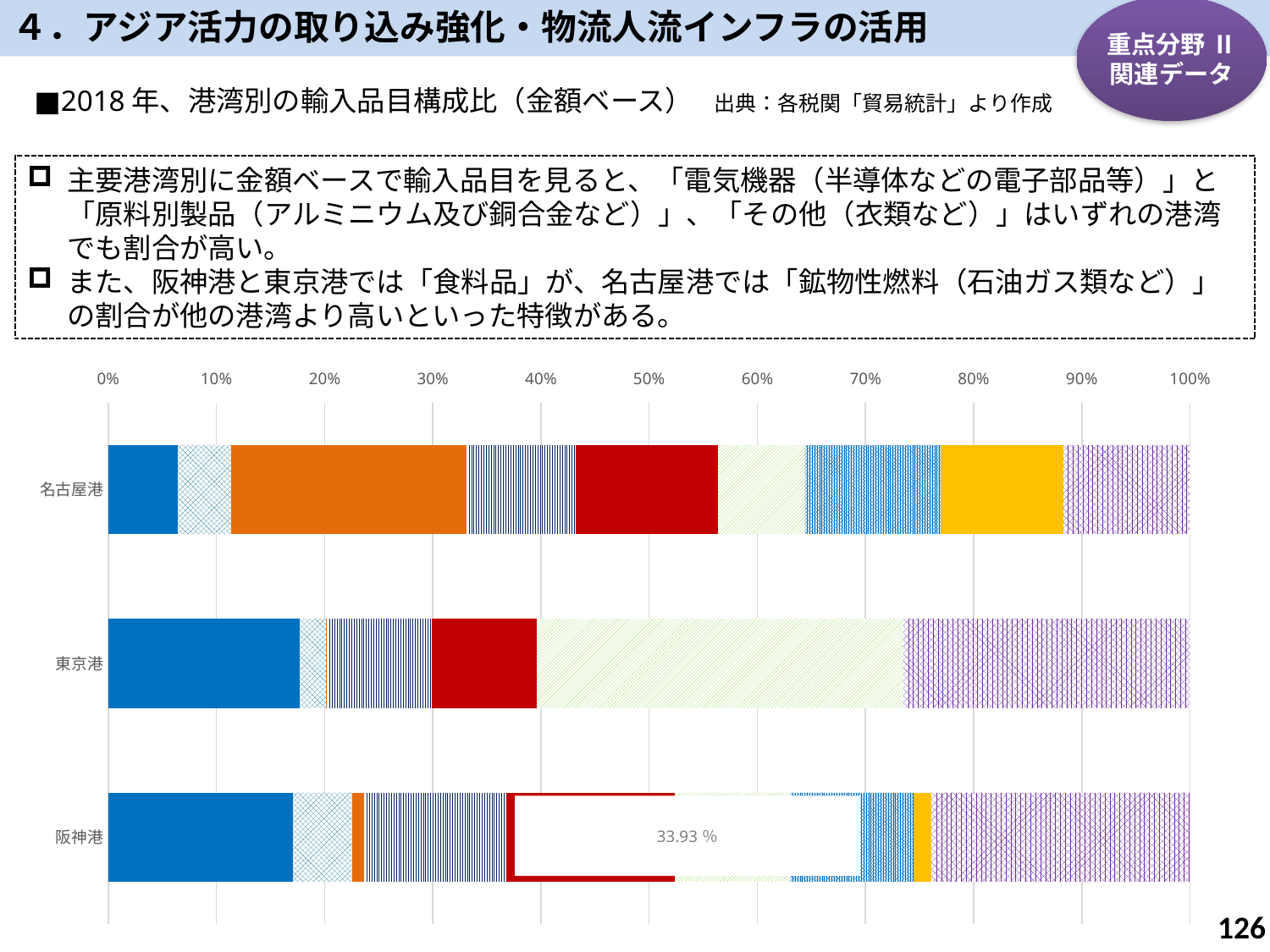
Is the first (solid blue) segment of the 東京港 bar greater or less than 10%? greater Which port has the largest green hatched segment? 東京港 How many ports (categories) are plotted in the chart? 3 Is the first (solid blue) segment of the 阪神港 bar greater or less than 10%? greater Which port has the largest solid red segment? 阪神港 What is the highest value shown on the horizontal axis? 100% What kind of chart is shown on the slide? Stacked bar chart What value is printed as a data label on the 阪神港 bar? 33.93 % Which port has the larger solid blue first segment, 名古屋港 or 東京港? 東京港 Is the first (solid blue) segment of the 名古屋港 bar greater or less than 10%? less Which port's bar carries the printed data label 33.93 %? 阪神港 Which port has the largest solid orange segment? 名古屋港